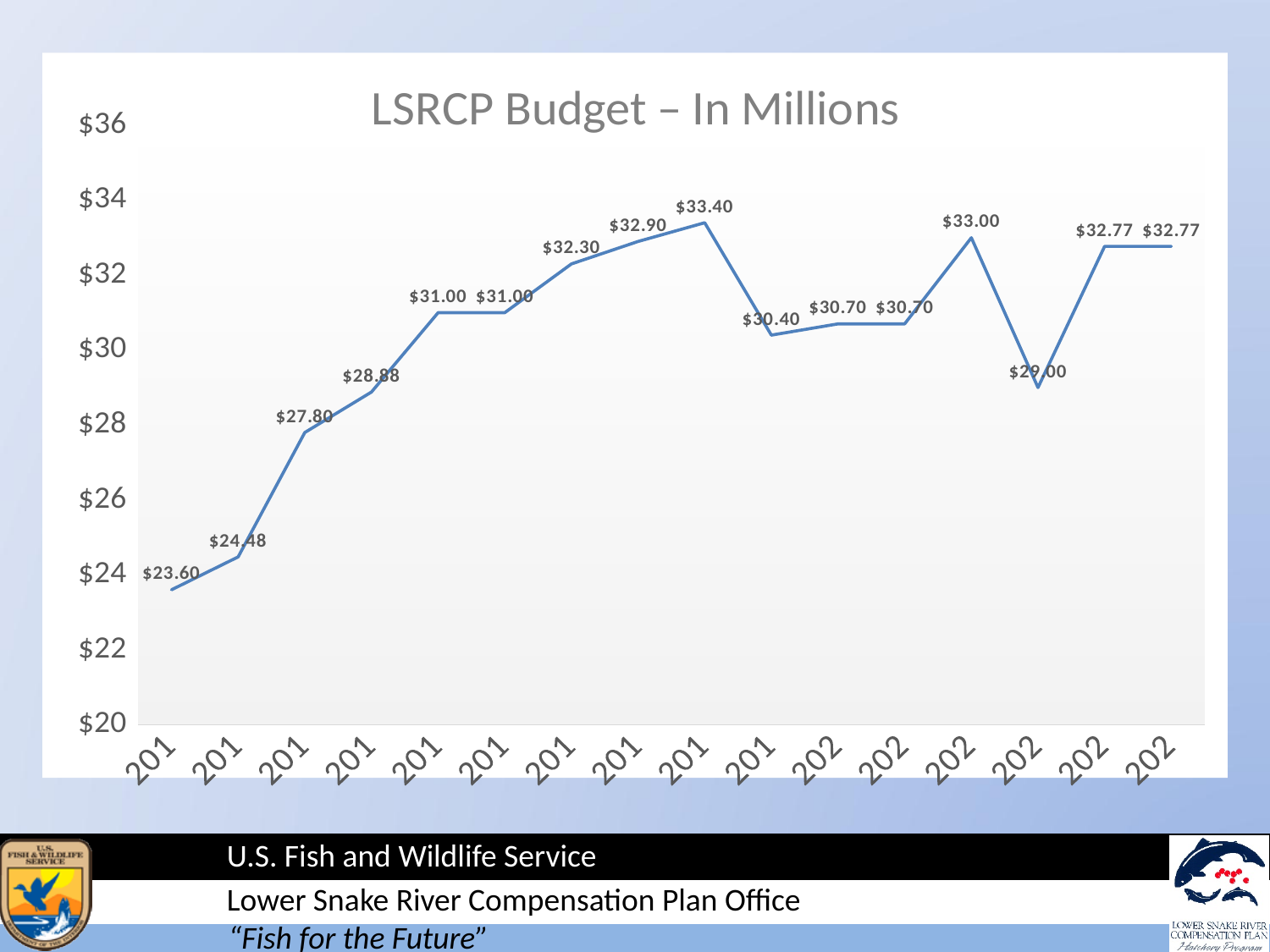
What is the highest value shown on the chart? $33.40 Which is larger, the second data point ($24.48) or the third data point ($27.80)? $27.80 What kind of chart is shown on the slide? line chart What is the value of the last data point on the right of the chart? $32.77 What is the lowest value shown on the chart? $23.60 What is the difference between the $33.00 data point and the $29.00 data point that immediately follows it? $4.00 What is the difference between the highest value ($33.40) and the lowest value ($23.60) on the chart? $9.80 How many data points are plotted on the line? 16 Do the values generally rise or fall across the first nine data points from left to right? rise Is the lowest value on the chart greater or less than $24? less What is the value of the first data point on the left of the chart? $23.60 What is the title of the chart? LSRCP Budget – In Millions